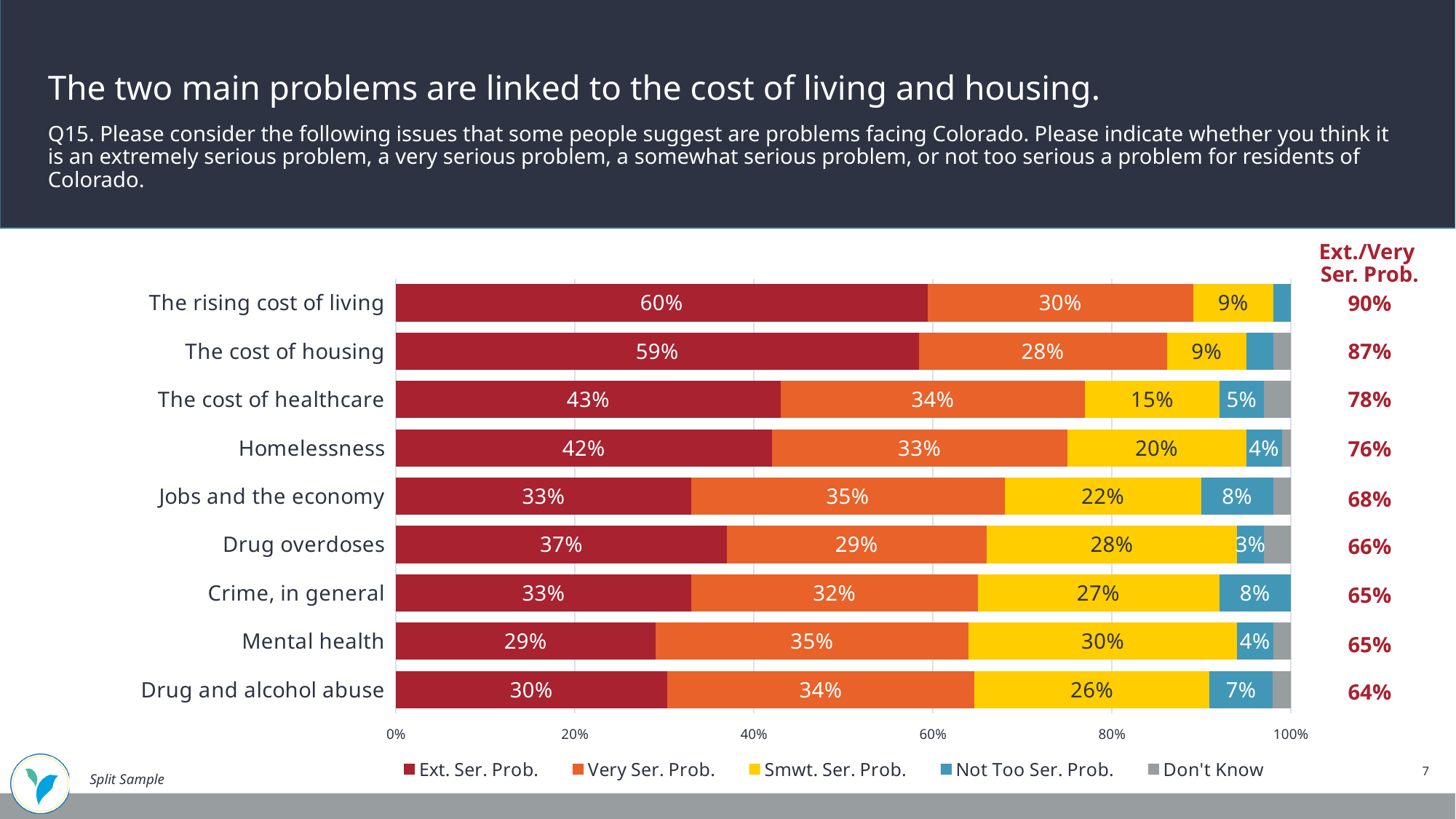
What is the Not Too Ser. Prob. value for Jobs and the economy? 8% Which is larger: the Smwt. Ser. Prob. value for Drug overdoses or for Crime, in general? Drug overdoses What percentage rated the rising cost of living as an extremely serious problem? 60% Which issue has the highest Ext. Ser. Prob. value? The rising cost of living What is the combined Ext./Very Ser. Prob. value shown for Drug and alcohol abuse? 64% What is the Smwt. Ser. Prob. value for Mental health? 30% What is the difference between the Ext. Ser. Prob. values for the cost of housing and Homelessness? 17% How many issues are shown in the chart? 9 What kind of chart is shown on the slide? Stacked bar chart How many series does the legend list? 5 What is the Very Ser. Prob. value for the cost of healthcare? 34% Which issue has the lowest Ext. Ser. Prob. value? Mental health